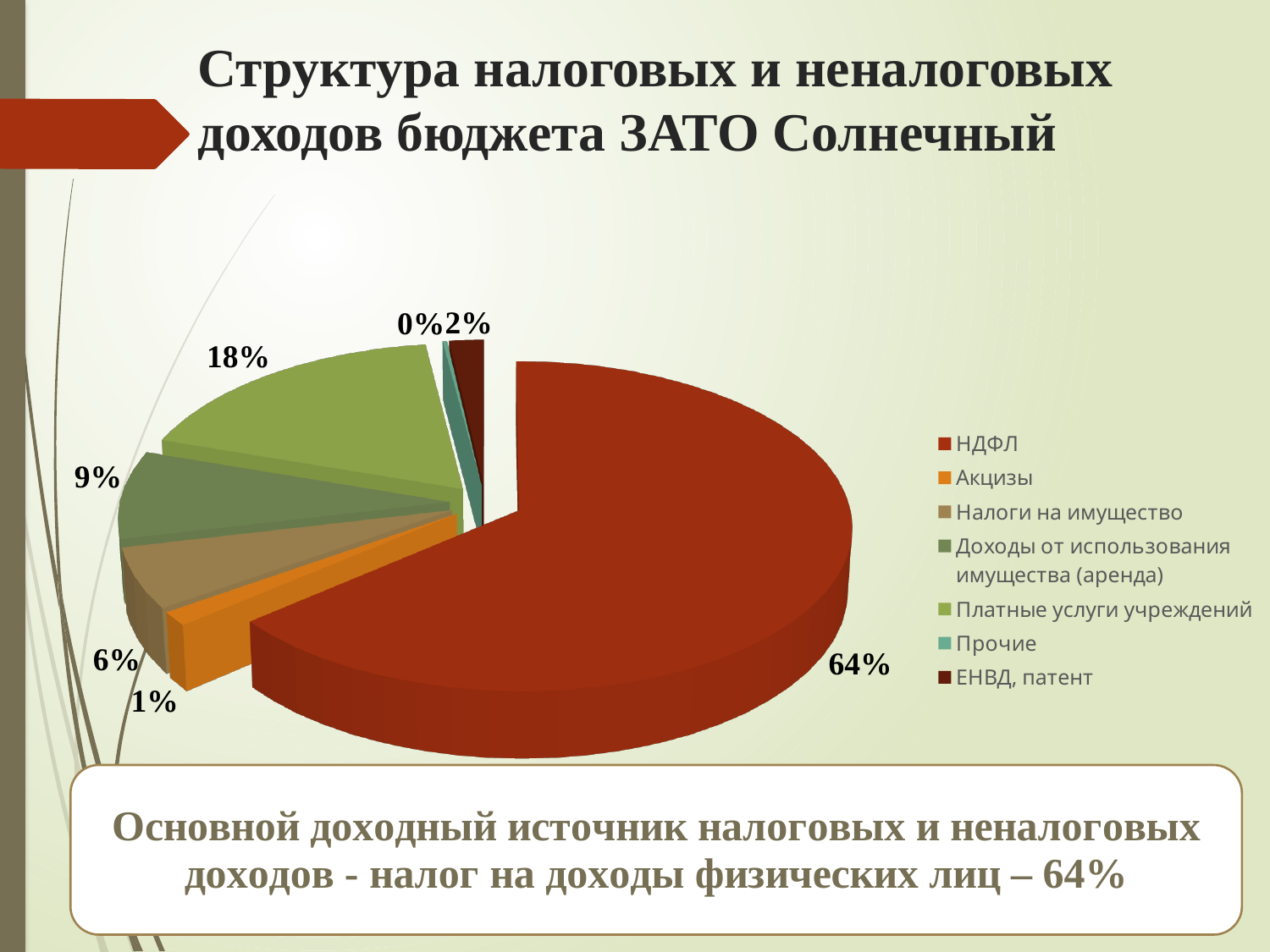
How many categories does the legend list? 7 What percentage is shown for ЕНВД, патент? 2% What percentage is shown for Прочие? 0% What share of the pie does НДФЛ account for? 64% Which category has the smallest slice of the pie? Прочие What kind of chart is shown on the slide? Pie chart What is the title of the slide containing the chart? Структура налоговых и неналоговых доходов бюджета ЗАТО Солнечный Which category has the largest slice of the pie? НДФЛ What percentage is shown for Доходы от использования имущества (аренда)? 9% Which is larger: the share for Платные услуги учреждений or the share for Доходы от использования имущества (аренда)? Платные услуги учреждений What percentage is shown for Платные услуги учреждений? 18% By how many percentage points does the НДФЛ share exceed the Платные услуги учреждений share? 46 percentage points